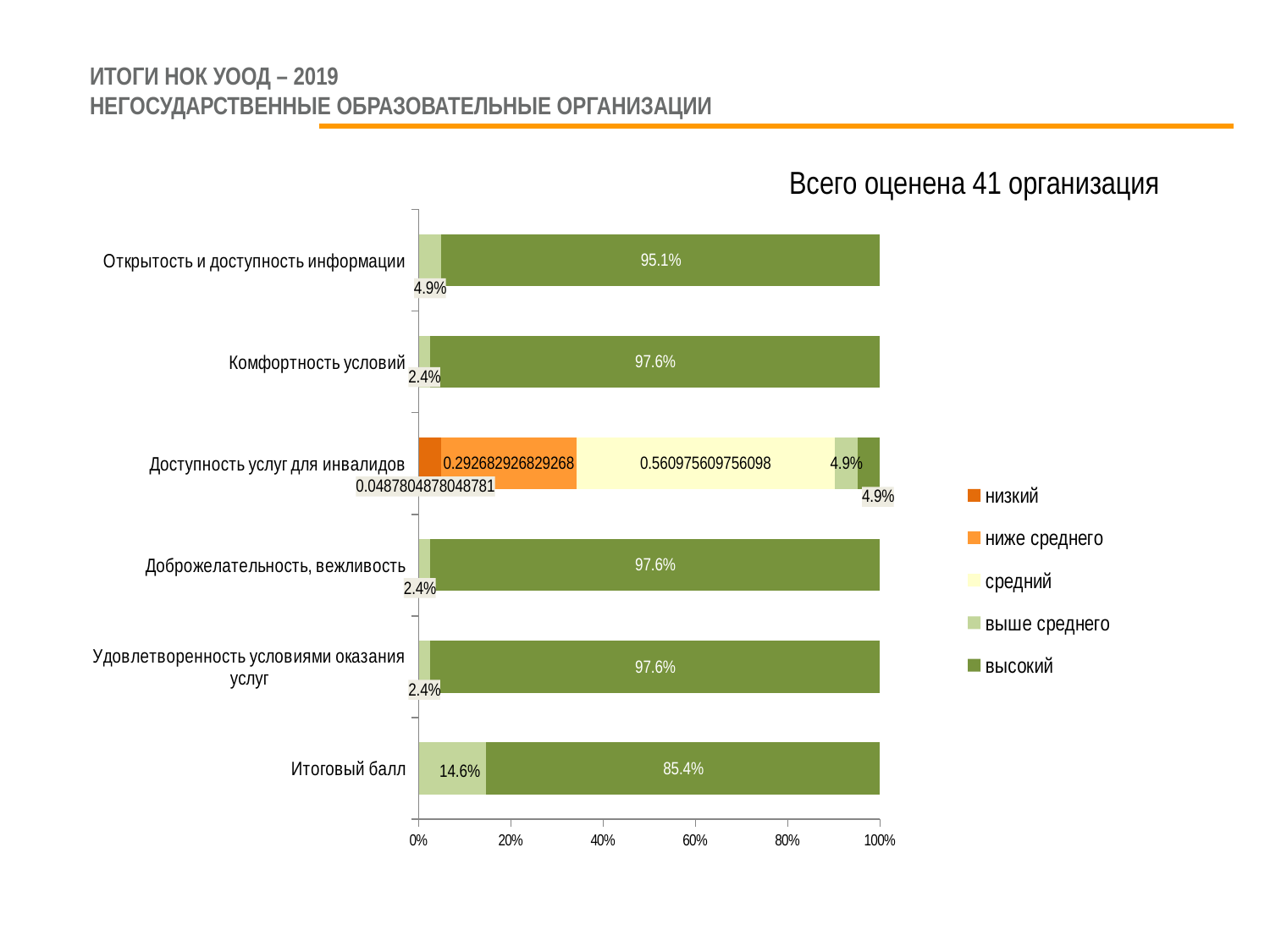
What is the difference between the «высокий» value for «Открытость и доступность информации» and the «высокий» value for «Итоговый балл»? 9.7% How many categories are shown on the chart? 6 What is the value of the «ниже среднего» series for «Доступность услуг для инвалидов»? 0.292682926829268 What is the value of the «выше среднего» series for «Итоговый балл»? 14.6% Which has the larger «выше среднего» value: «Итоговый балл» or «Открытость и доступность информации»? Итоговый балл Is the «средний» value for «Доступность услуг для инвалидов» greater or less than 40%? greater What is the value of the «высокий» series for «Комфортность условий»? 97.6% What kind of chart is shown on the slide? Stacked bar chart How many series does the legend list? 5 Which category has the lowest value for the «высокий» series? Доступность услуг для инвалидов What is the value of the «высокий» series for «Открытость и доступность информации»? 95.1% What is the value of the «средний» series for «Доступность услуг для инвалидов»? 0.560975609756098